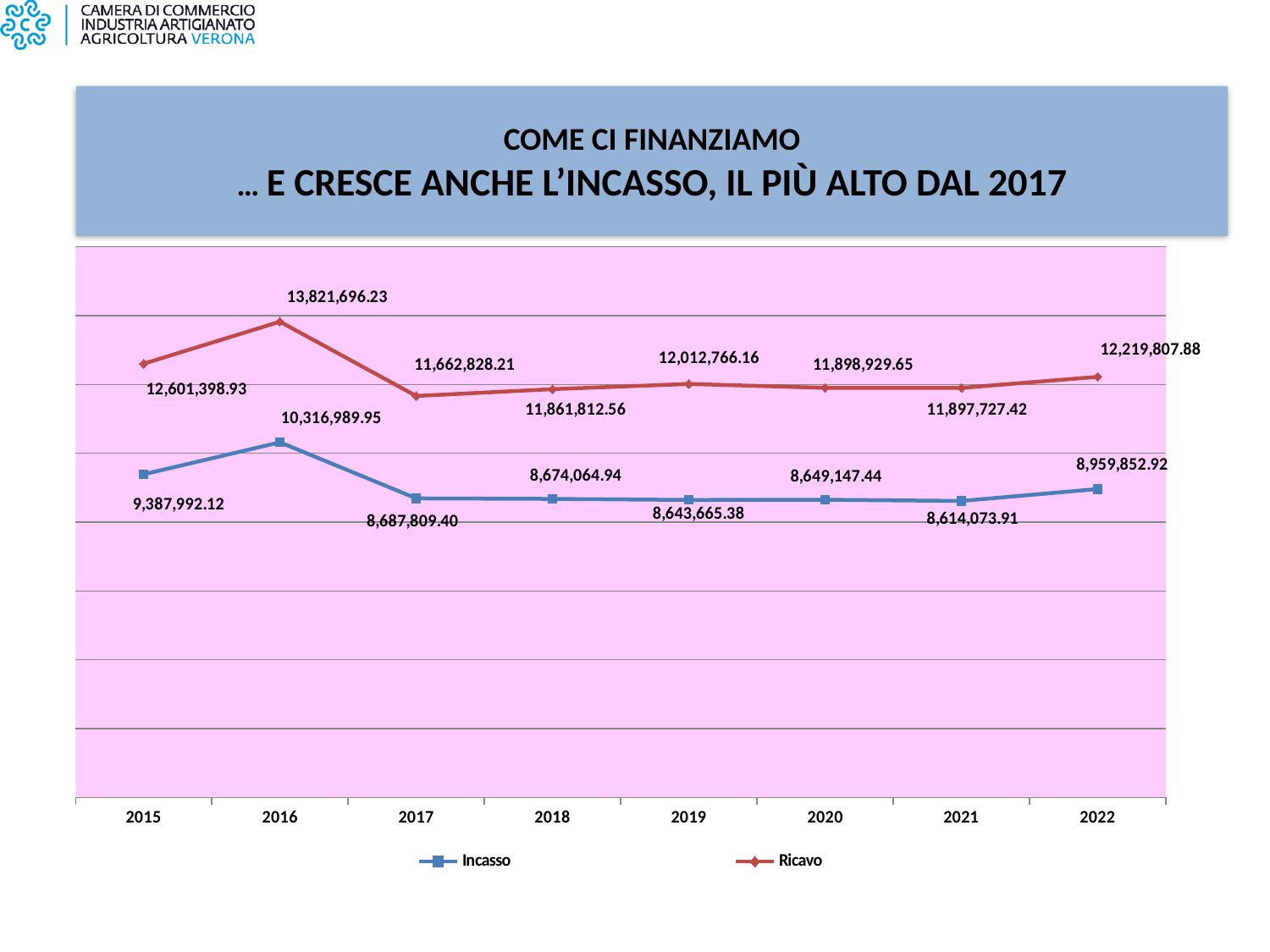
What is the Ricavo value for 2016? 13,821,696.23 What is the Incasso value for 2022? 8,959,852.92 By how much did Incasso increase from 2015 to 2016? 928,997.83 In which year is Ricavo lowest? 2017 What is the difference between Ricavo and Incasso in 2022? 3,259,954.96 Which is larger, Incasso in 2016 or Incasso in 2022? Incasso in 2016 How many series does the legend list? 2 What type of chart is shown on the slide? Line chart What is the Incasso value for 2019? 8,643,665.38 In which year is Ricavo highest? 2016 How many years are plotted on the x axis? 8 Which series is drawn in red? Ricavo